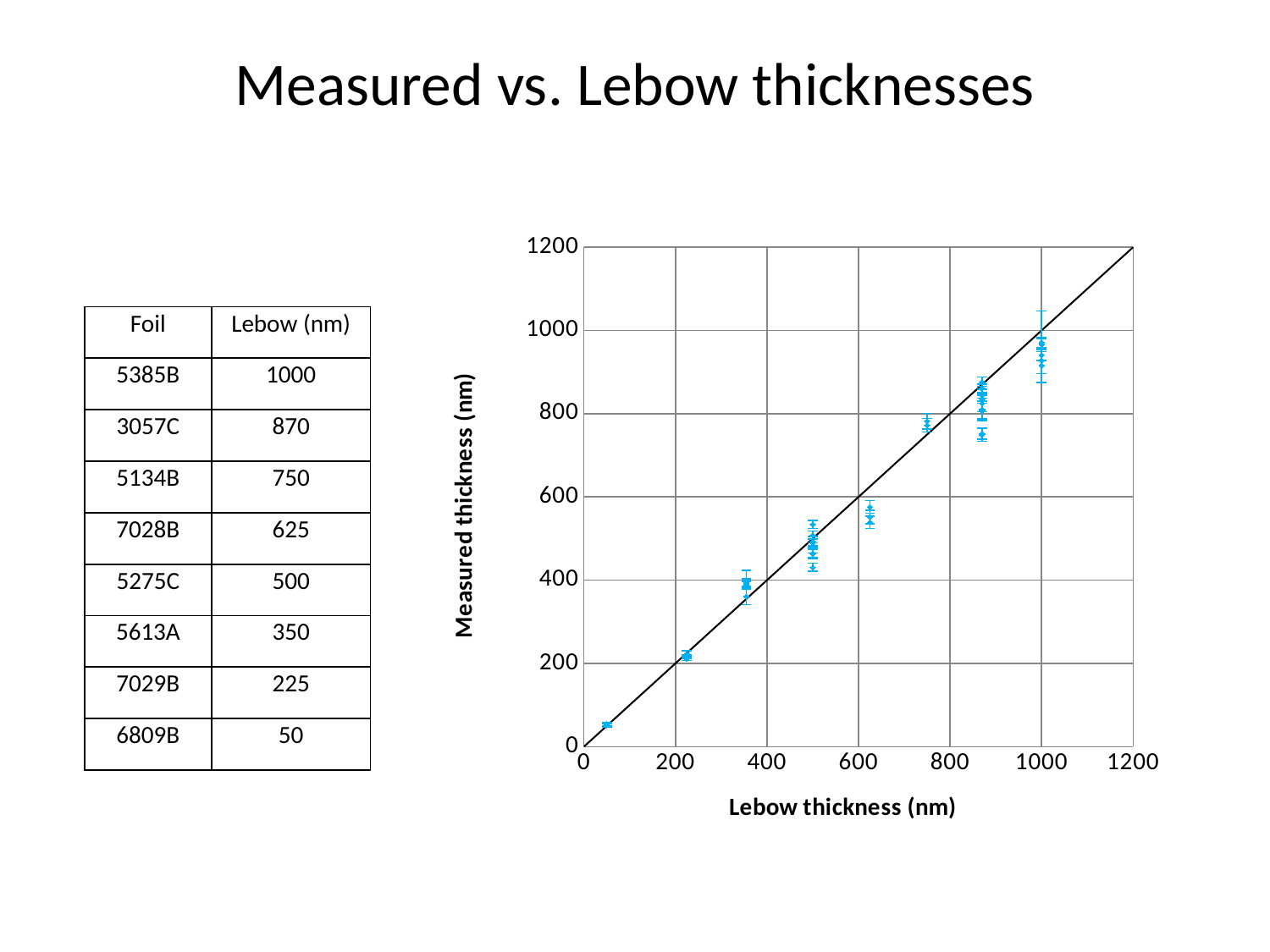
Are the measured thickness values at a Lebow thickness of 750 nm greater or less than 600? greater Does the measured thickness rise or fall as the Lebow thickness increases along the x axis? rise What kind of chart is shown on the slide? scatter chart What is the title of the x axis of the chart? Lebow thickness (nm) Are the measured thickness values at a Lebow thickness of 870 nm greater or less than 1000? less Is the measured thickness at a Lebow thickness of 50 nm greater or less than 200? less How many distinct Lebow thickness values have points plotted on the chart? 8 What is the title of the y axis of the chart? Measured thickness (nm)